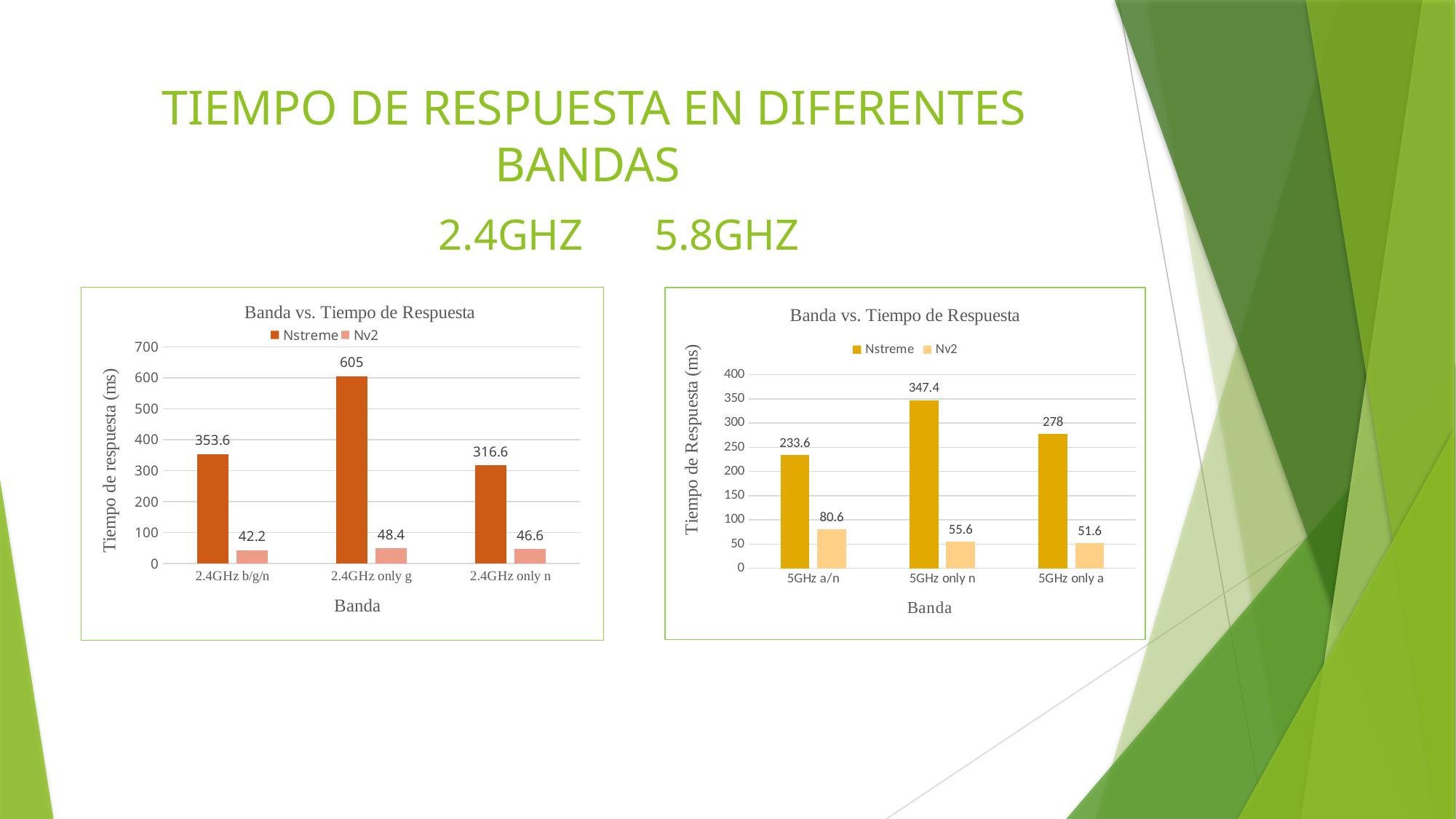
In the right chart (5.8GHz), is the Nstreme value for 5GHz only n greater or less than 300? greater In the right chart (5.8GHz), what is the difference between the Nstreme values for 5GHz only n and 5GHz a/n? 113.8 In the left chart (2.4GHz), which category has the highest Nstreme value? 2.4GHz only g In the left chart (2.4GHz), which is larger: the Nv2 value for 2.4GHz only g or for 2.4GHz only n? 2.4GHz only g In the right chart (5.8GHz), which category has the lowest Nv2 value? 5GHz only a In the right chart (5.8GHz), what is the Nv2 value for 5GHz a/n? 80.6 What type of chart is the left chart (2.4GHz)? Bar chart In the left chart (2.4GHz), what is the Nv2 value for 2.4GHz b/g/n? 42.2 How many series does the legend of the right chart (5.8GHz) list? 2 In the left chart (2.4GHz), what is the Nstreme value for 2.4GHz only g? 605 In the right chart (5.8GHz), what is the Nstreme value for 5GHz only a? 278 How many categories are shown on the x axis of the left chart (2.4GHz)? 3